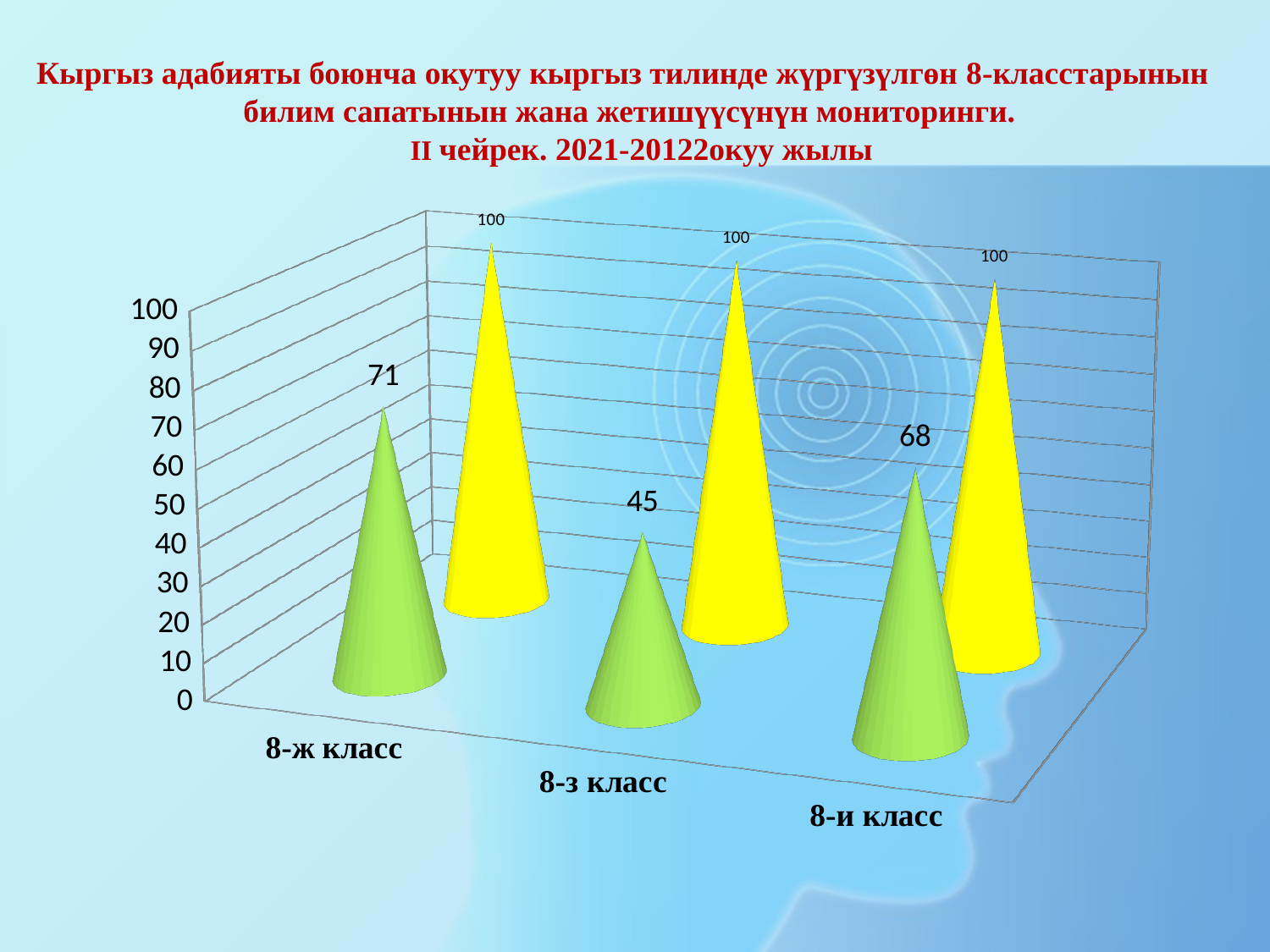
What is the value of the yellow cone for 8-з класс? 100 Which is larger, the green cone value for 8-з класс or for 8-и класс? 8-и класс What is the value of the green cone for 8-и класс? 68 What is the maximum value shown on the vertical axis of the chart? 100 What colour are the cones that all have the value 100? Yellow Which class has the lowest green cone value? 8-з класс What is the difference between the green cone values for 8-ж класс and 8-з класс? 26 What is the value of the green cone for 8-ж класс? 71 What is the difference between the yellow and green cone values for 8-и класс? 32 What is the value of the green cone for 8-з класс? 45 How many classes are shown on the x axis of the chart? 3 Which class has the highest green cone value? 8-ж класс